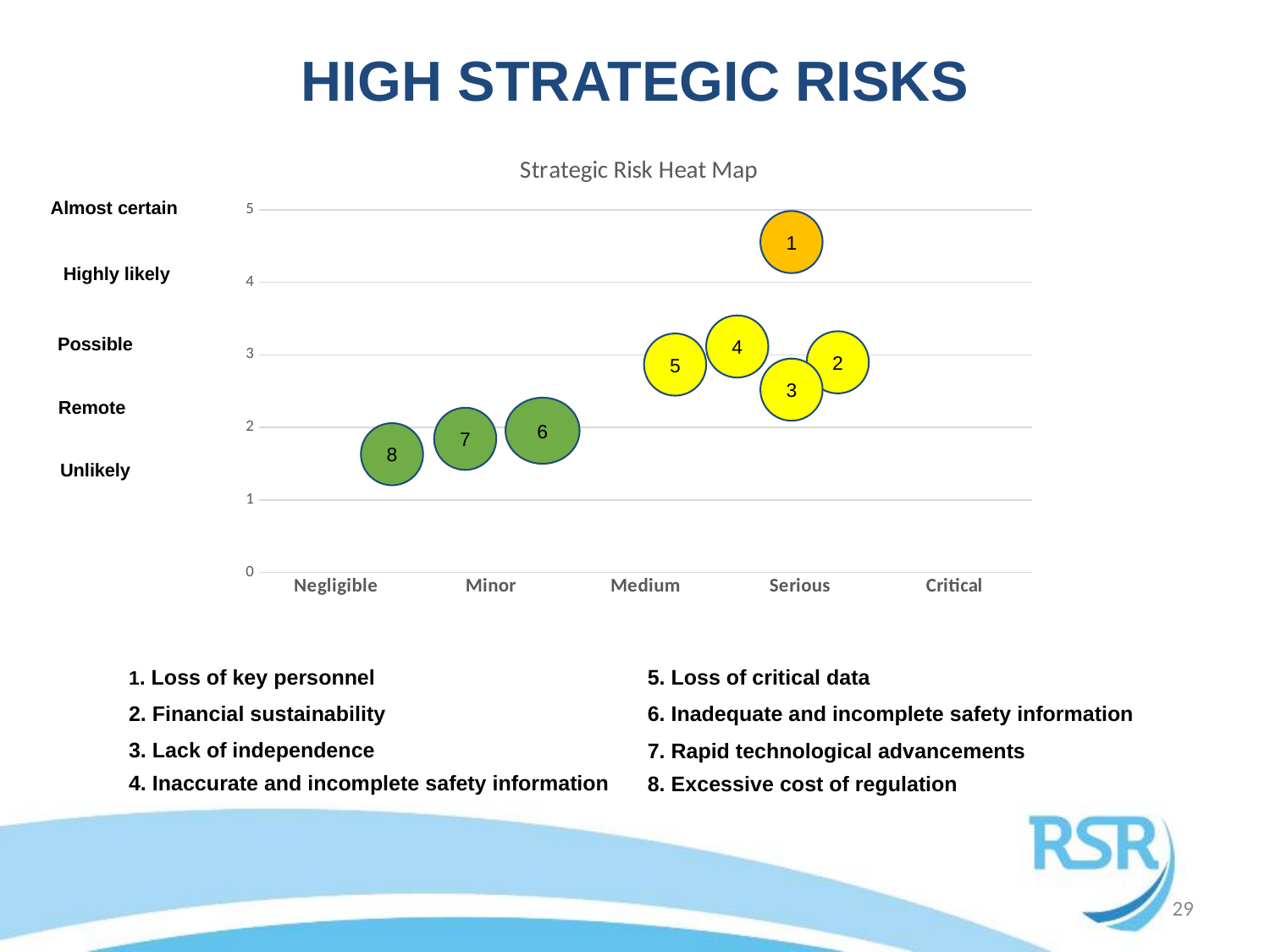
Is the vertical value for bubble 1 greater or less than 4? greater Which numbered bubble is plotted lowest on the chart? 8 Is the vertical value for bubble 3 greater or less than 3? less What colour is bubble 1 on the chart? orange Which numbered bubble is plotted furthest to the right on the chart? 2 Is the vertical value for bubble 8 greater or less than 2? less Which numbered bubble is plotted highest on the chart? 1 Which is plotted higher on the chart, bubble 1 or bubble 8? bubble 1 What kind of chart is shown on the slide? bubble chart How many numbered bubbles are plotted on the chart? 8 How many categories are shown on the x axis of the chart? 5 What is the title of the chart? Strategic Risk Heat Map